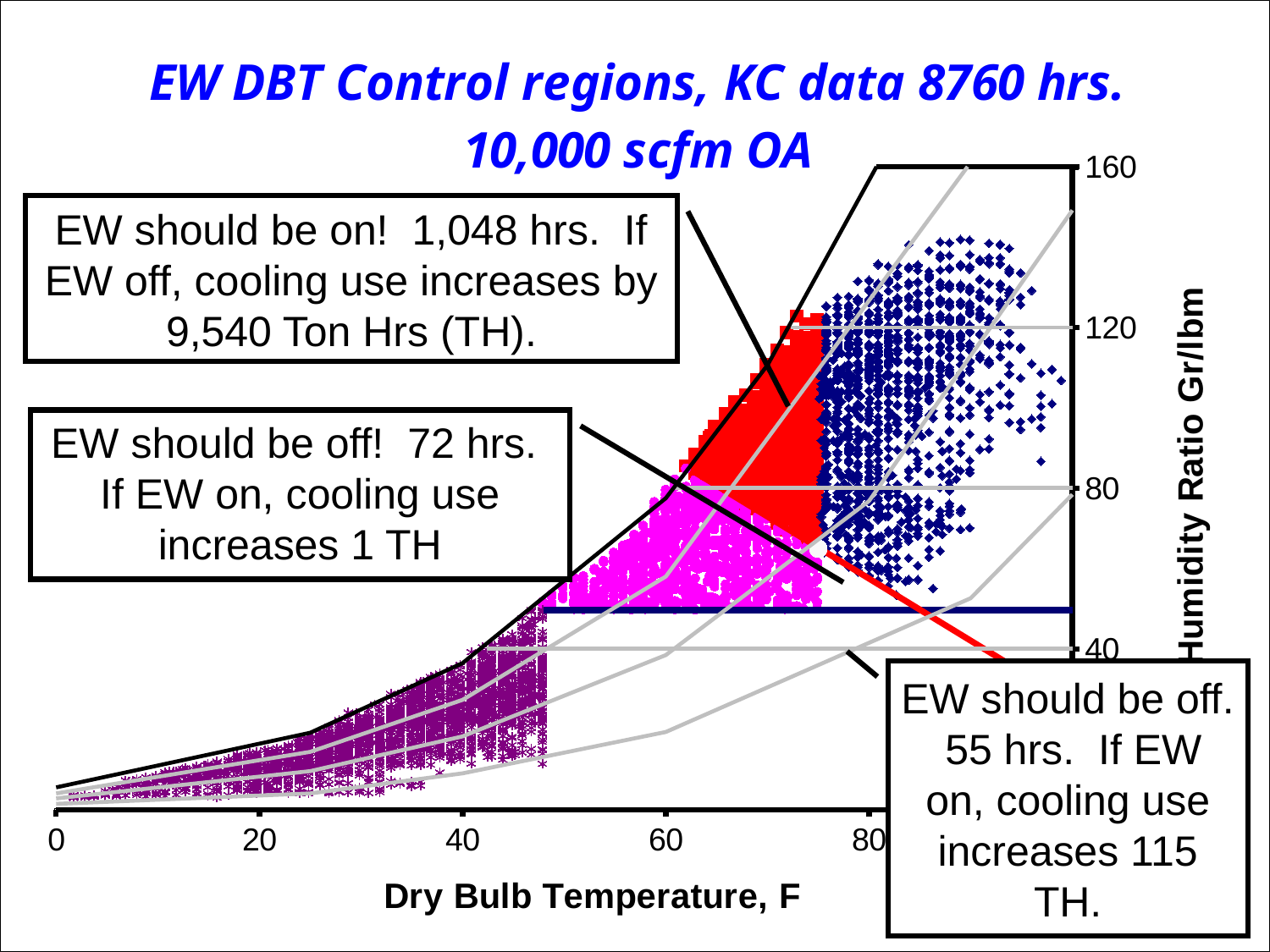
Which annotated region has the fewest hours? EW should be off. 55 hrs. How many hours are in the 'EW should be off! ... increases 1 TH' region? 72 hrs. Which is larger: the 72 hrs. region or the 55 hrs. region? 72 hrs. region What is the highest value shown on the Humidity Ratio axis? 160 How many hours are in the region where cooling use increases 115 TH if EW is on? 55 hrs. What is the label of the x axis? Dry Bulb Temperature, F How many hours are in the region labelled 'EW should be on!'? 1,048 hrs. What kind of chart is shown on the slide? scatter chart Which annotated region has the most hours? EW should be on! (1,048 hrs.) What is the title of the chart? EW DBT Control regions, KC data 8760 hrs. 10,000 scfm OA What is the difference in hours between the 'EW should be on!' region (1,048 hrs.) and the 72 hrs. 'EW should be off!' region? 976 hrs. By how many Ton Hrs does cooling use increase if EW is off in the 'EW should be on!' region? 9,540 Ton Hrs (TH)